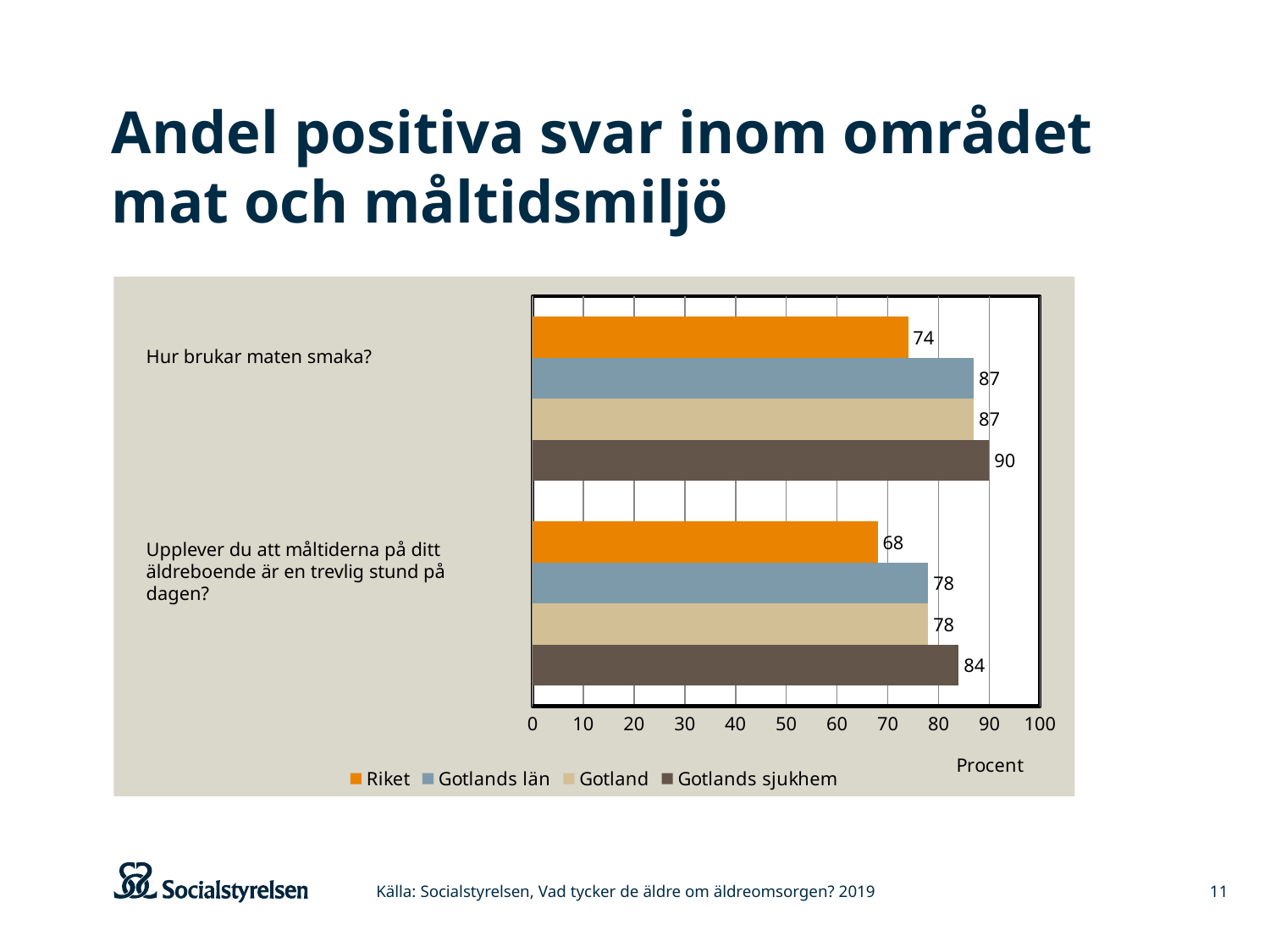
What is the value for Riket for "Upplever du att måltiderna på ditt äldreboende är en trevlig stund på dagen?"? 68 Which series has the lowest value for "Upplever du att måltiderna på ditt äldreboende är en trevlig stund på dagen?"? Riket Which series has the highest value for "Hur brukar maten smaka?"? Gotlands sjukhem What is the value for Riket for "Hur brukar maten smaka?"? 74 What is the difference between Gotlands sjukhem and Gotland for "Upplever du att måltiderna på ditt äldreboende är en trevlig stund på dagen?"? 6 How many series does the legend list? 4 What is the value for Gotlands län for "Upplever du att måltiderna på ditt äldreboende är en trevlig stund på dagen?"? 78 What is the difference between Gotlands sjukhem and Riket for "Hur brukar maten smaka?"? 16 What kind of chart is shown on the slide? Bar chart What is the value for Gotlands sjukhem for "Hur brukar maten smaka?"? 90 Which is larger: the Riket value for "Hur brukar maten smaka?" or the Riket value for "Upplever du att måltiderna på ditt äldreboende är en trevlig stund på dagen?"? Hur brukar maten smaka? What unit is shown on the horizontal axis of the chart? Procent